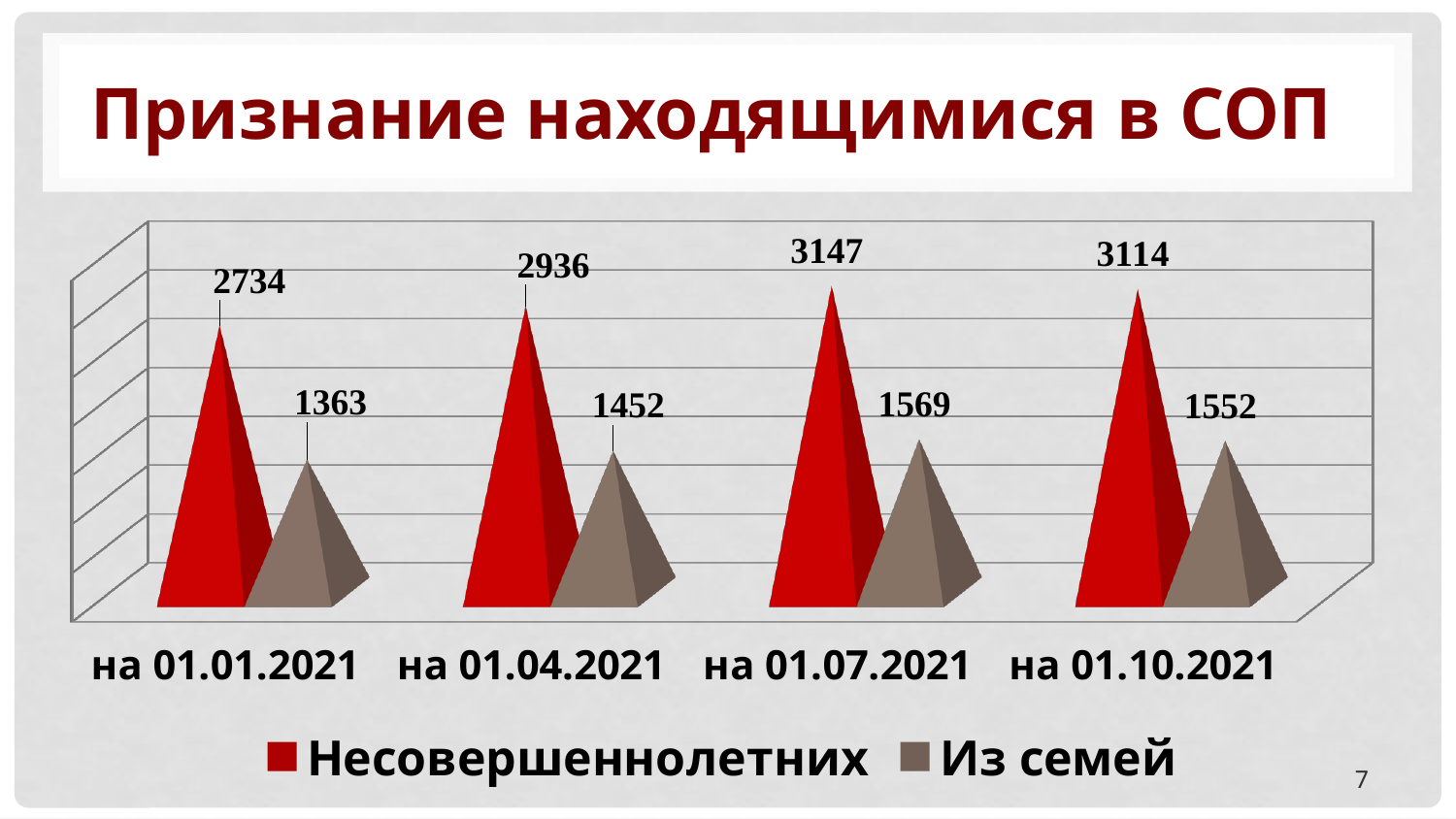
What is the value for Несовершеннолетних на 01.01.2021? 2734 What is the difference between Несовершеннолетних and Из семей на 01.04.2021? 1484 What is the value for Из семей на 01.04.2021? 1452 On which date is the value for Несовершеннолетних highest? на 01.07.2021 How many dates (categories) are shown on the x axis? 4 How many series does the legend list? 2 What is the title of the chart on the slide? Признание находящимися в СОП What is the value for Из семей на 01.07.2021? 1569 Which is larger: Несовершеннолетних на 01.07.2021 or Несовершеннолетних на 01.10.2021? Несовершеннолетних на 01.07.2021 What is the value for Несовершеннолетних на 01.10.2021? 3114 What kind of chart is shown on the slide? bar chart On which date is the value for Из семей lowest? на 01.01.2021